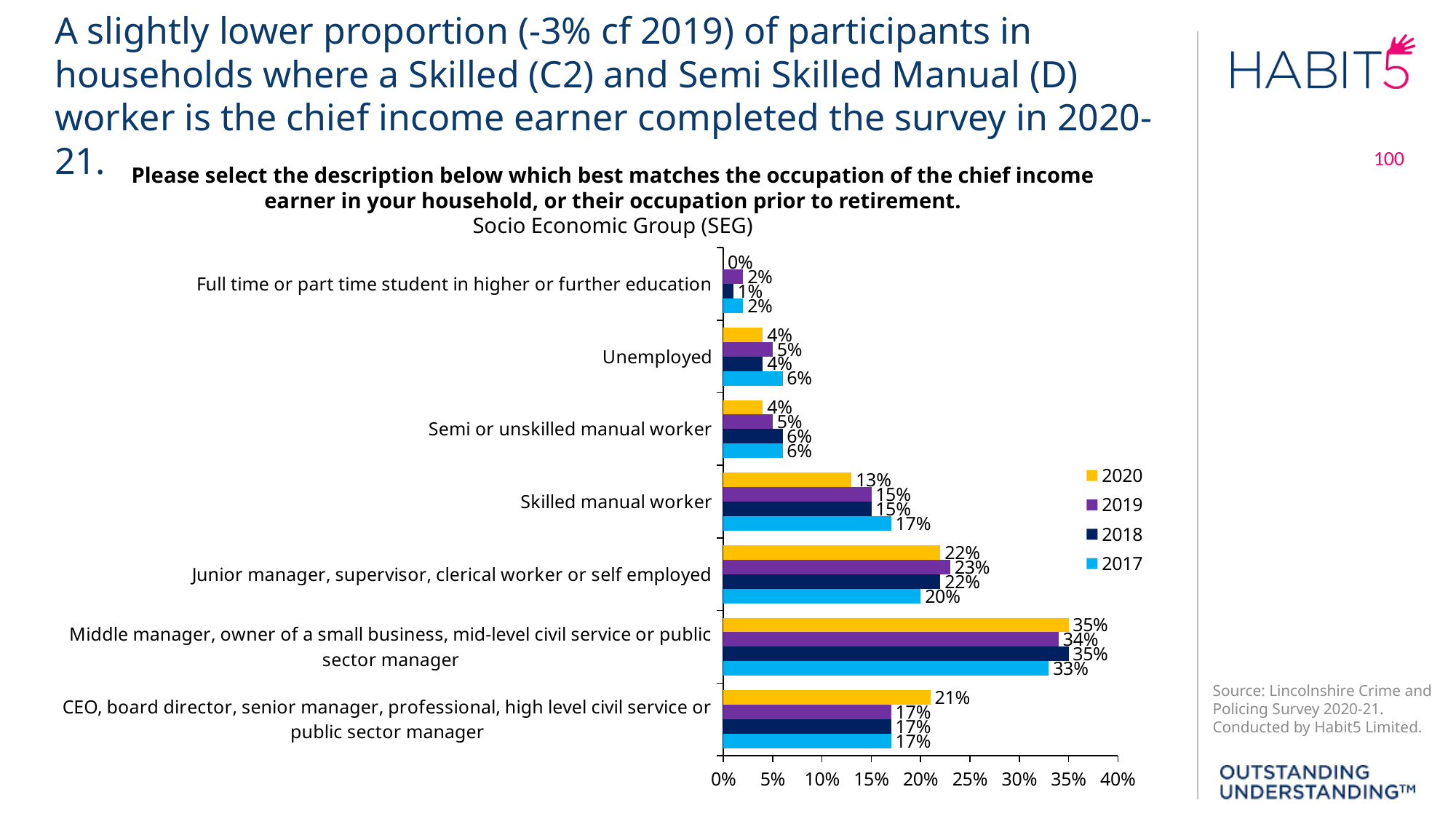
How many series does the legend list? 4 What is the difference between the 2017 and 2020 values for Skilled manual worker? 4% What is the 2017 value for Unemployed? 6% What is the 2019 value for Middle manager, owner of a small business, mid-level civil service or public sector manager? 34% Which series is shown in yellow in the legend? 2020 What is the difference between the 2020 and 2019 values for CEO, board director, senior manager, professional, high level civil service or public sector manager? 4% What kind of chart is shown on the slide? bar chart Which category has the lowest 2020 value? Full time or part time student in higher or further education What is the 2020 value for Skilled manual worker? 13% How many occupation categories are shown on the chart? 7 Which is larger for Skilled manual worker: the 2017 value or the 2020 value? 2017 Which category has the highest 2020 value? Middle manager, owner of a small business, mid-level civil service or public sector manager